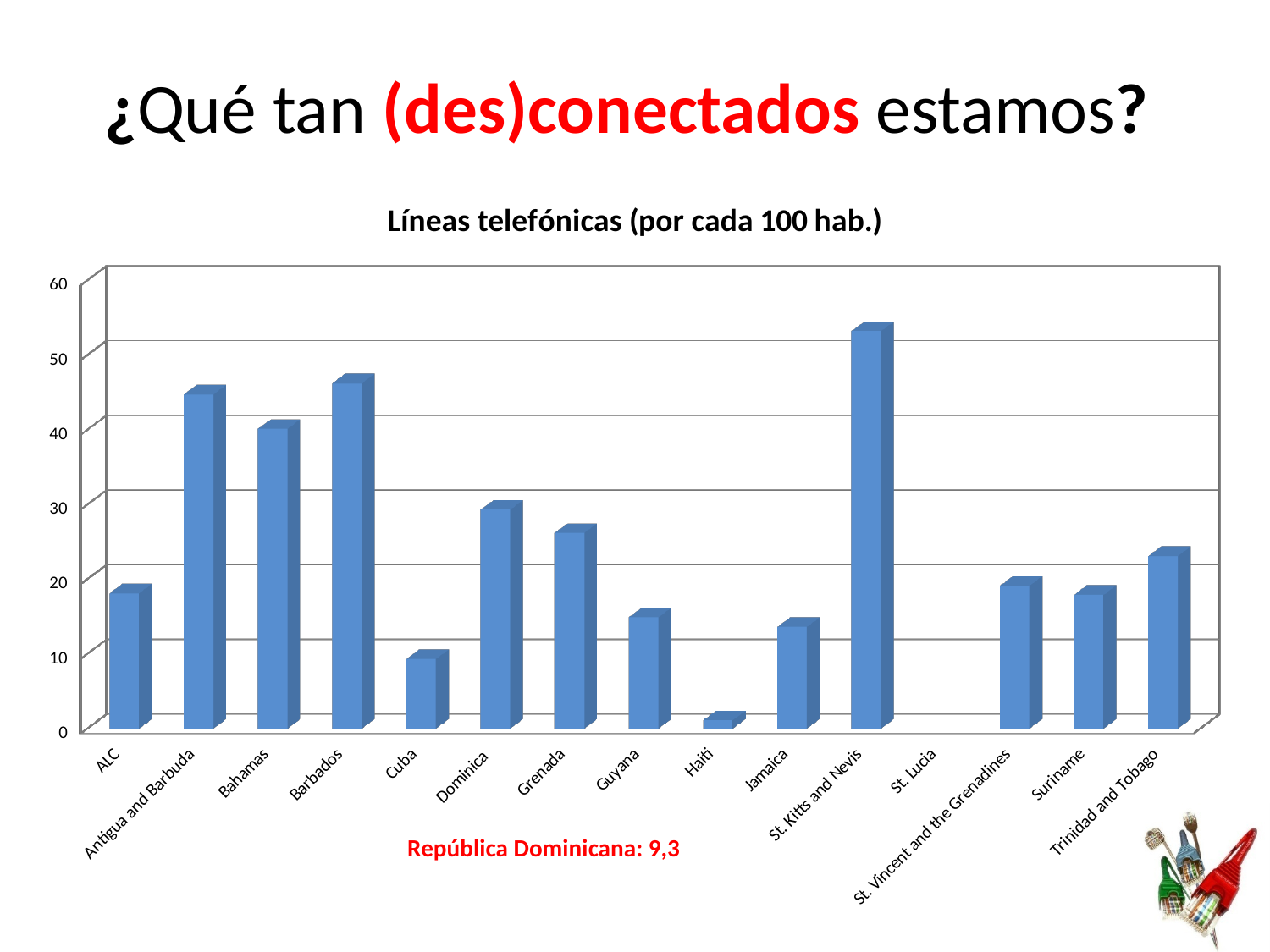
What value is given on the slide for República Dominicana? 9,3 Which has a larger value, Barbados or Bahamas? Barbados Is the value for St. Kitts and Nevis greater or less than 50? greater Is the value for Antigua and Barbuda greater or less than 40? greater Which category has the highest value in the chart? St. Kitts and Nevis What kind of chart is shown on the slide? bar chart How many categories are shown along the x axis of the chart? 15 Is the value for Trinidad and Tobago greater or less than 20? greater Which has a larger value, Dominica or Grenada? Dominica Which category has the shortest visible bar in the chart? Haiti What is the title of the chart? Líneas telefónicas (por cada 100 hab.)